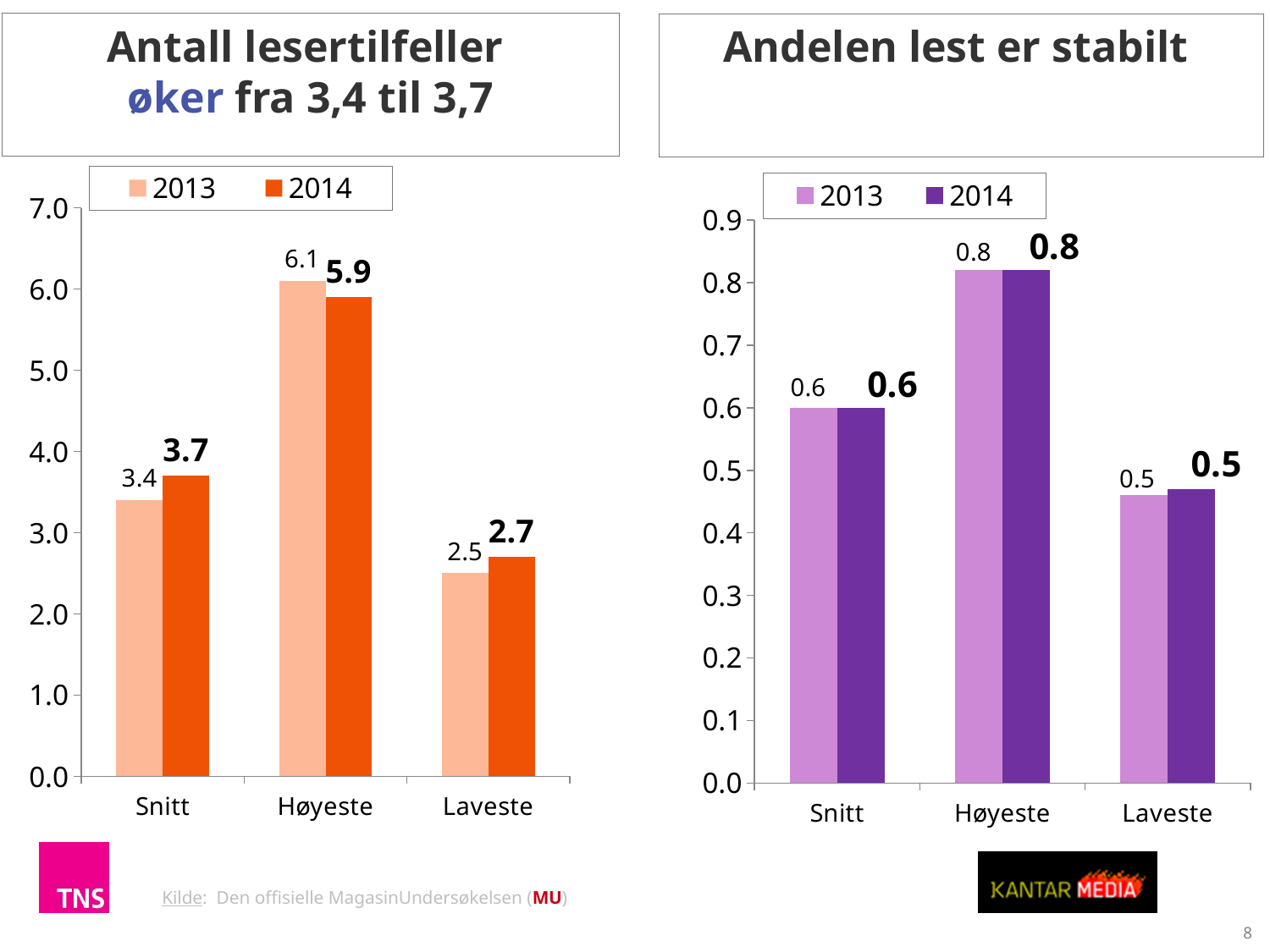
In the left chart (Antall lesertilfeller), which category has the highest 2014 value? Høyeste In the left chart (Antall lesertilfeller), is the 2013 value for Snitt or the 2014 value for Snitt larger? 2014 What kind of chart is the left chart (Antall lesertilfeller)? Bar chart In the right chart (Andelen lest er stabilt), what is the 2014 value for Høyeste? 0.8 In the right chart (Andelen lest er stabilt), which category has the highest 2013 value? Høyeste In the right chart (Andelen lest er stabilt), what is the 2013 value for Laveste? 0.5 In the left chart (Antall lesertilfeller), what is the 2013 value for Høyeste? 6.1 In the left chart (Antall lesertilfeller), what is the difference between the 2013 and 2014 values for Høyeste? 0.2 How many series does the legend of the right chart (Andelen lest er stabilt) list? 2 In the left chart (Antall lesertilfeller), which category has the lowest 2013 value? Laveste In the left chart (Antall lesertilfeller), what is the 2014 value for Snitt? 3.7 In the left chart (Antall lesertilfeller), what is the 2014 value for Laveste? 2.7